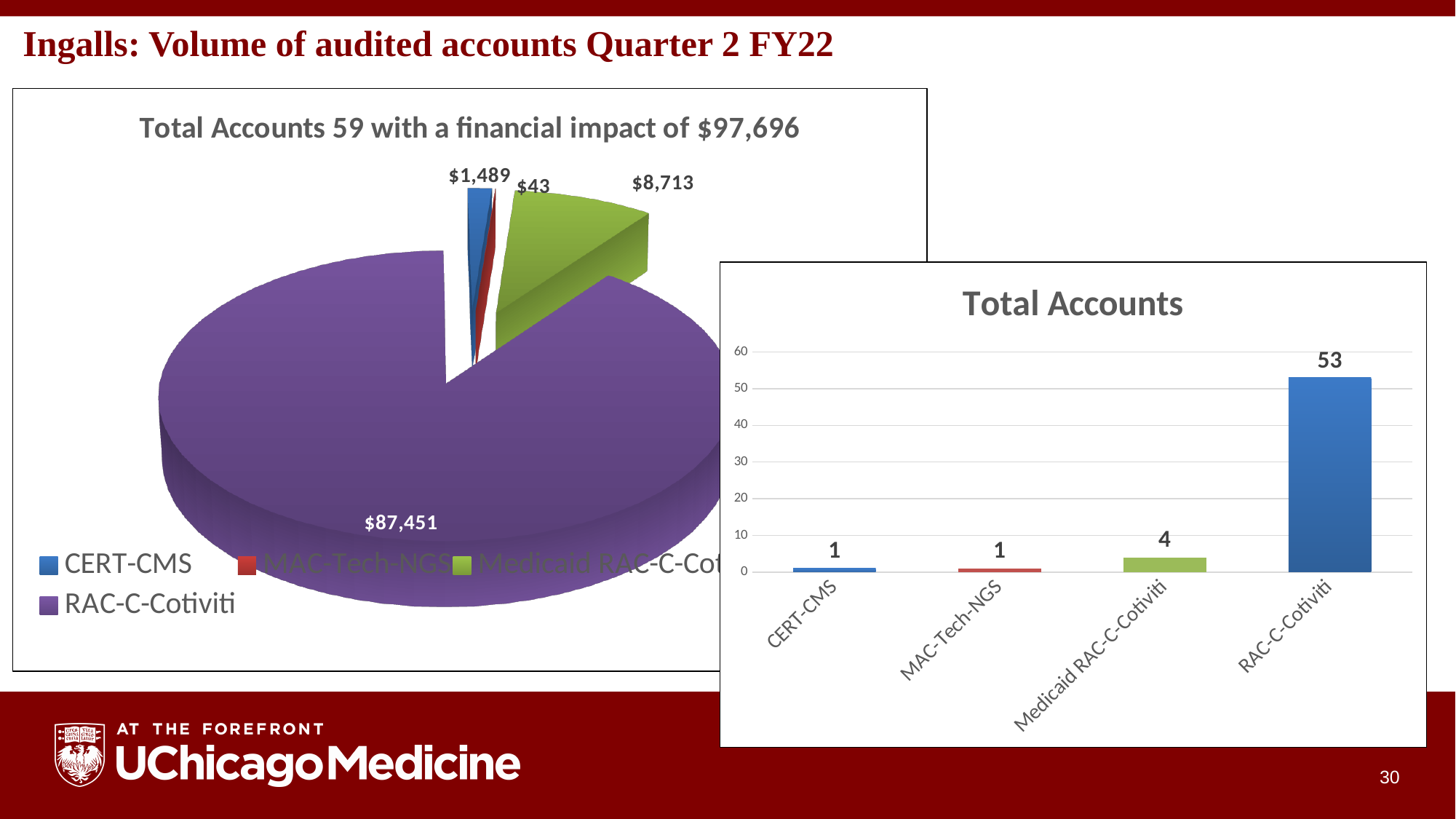
What is the title of the pie chart on the left of the slide? Total Accounts 59 with a financial impact of $97,696 In the pie chart on the left, what is the value labelled on the RAC-C-Cotiviti slice? $87,451 In the bar chart titled 'Total Accounts', what is the value for RAC-C-Cotiviti? 53 In the pie chart on the left, what is the difference between the RAC-C-Cotiviti value and the Medicaid RAC-C-Cotiviti value? $78,738 In the bar chart titled 'Total Accounts', how many categories are shown on the x axis? 4 In the bar chart titled 'Total Accounts', what is the value for Medicaid RAC-C-Cotiviti? 4 What kind of chart is the chart on the left of the slide? Pie chart In the pie chart on the left, what is the value labelled on the MAC-Tech-NGS slice? $43 In the bar chart titled 'Total Accounts', is the value for RAC-C-Cotiviti greater or less than 50? greater In the bar chart titled 'Total Accounts', what is the difference between the values for RAC-C-Cotiviti and Medicaid RAC-C-Cotiviti? 49 In the pie chart on the left, which category has the smallest slice? MAC-Tech-NGS In the bar chart titled 'Total Accounts', which category has the highest value? RAC-C-Cotiviti